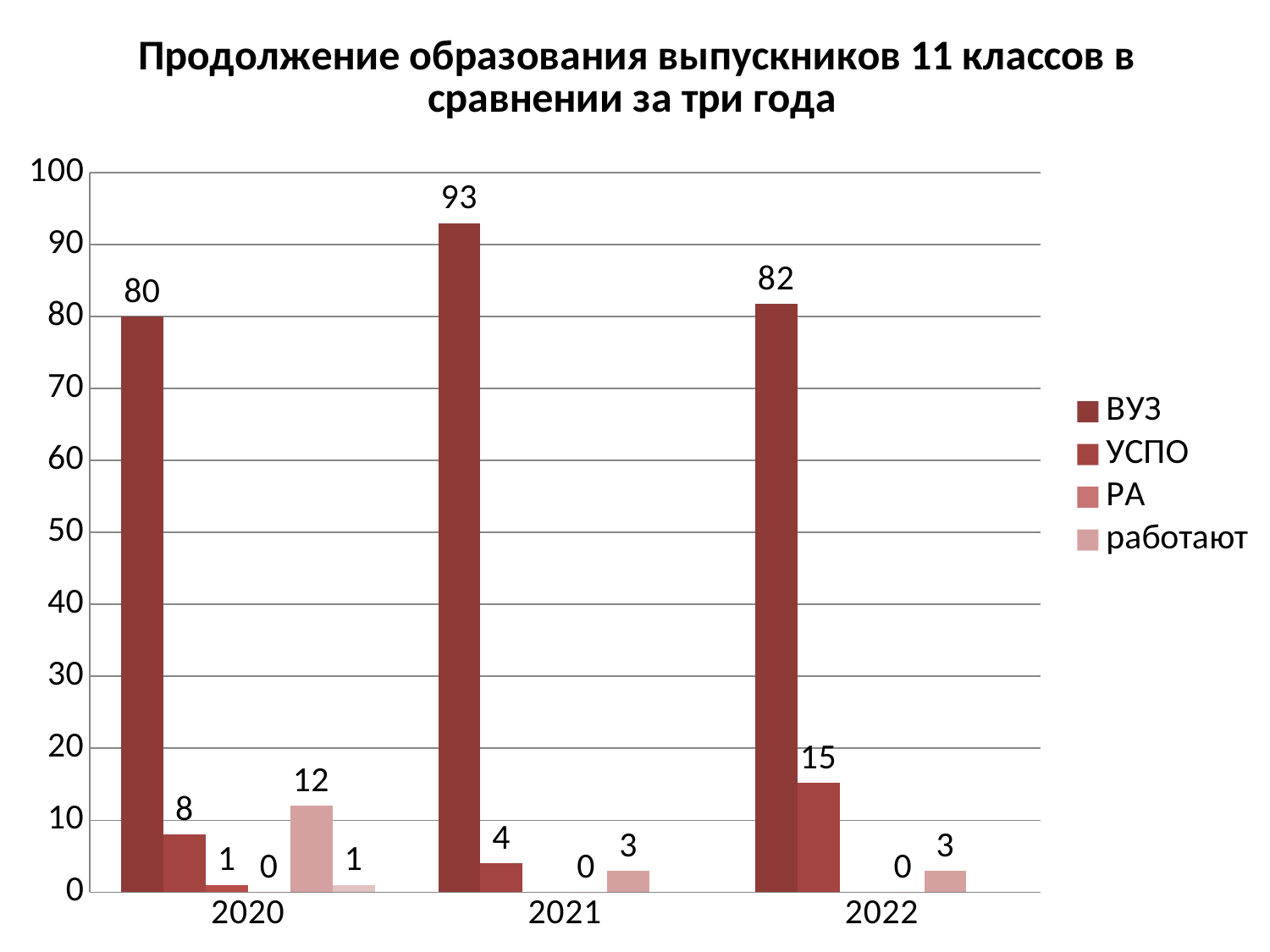
What is the difference between the ВУЗ values for 2021 and 2020? 13 How many years are shown on the x axis? 3 In which year is the ВУЗ value lowest? 2020 What is the value for работают in 2021? 3 How many series does the legend list? 4 What is the difference between the ВУЗ values for 2021 and 2022? 11 What is the value for УСПО in 2022? 15 What kind of chart is shown on the slide? bar chart What is the value for ВУЗ in 2022? 82 In which year is the ВУЗ value highest? 2021 Which year has the larger УСПО value, 2020 or 2022? 2022 What is the value for ВУЗ in 2021? 93